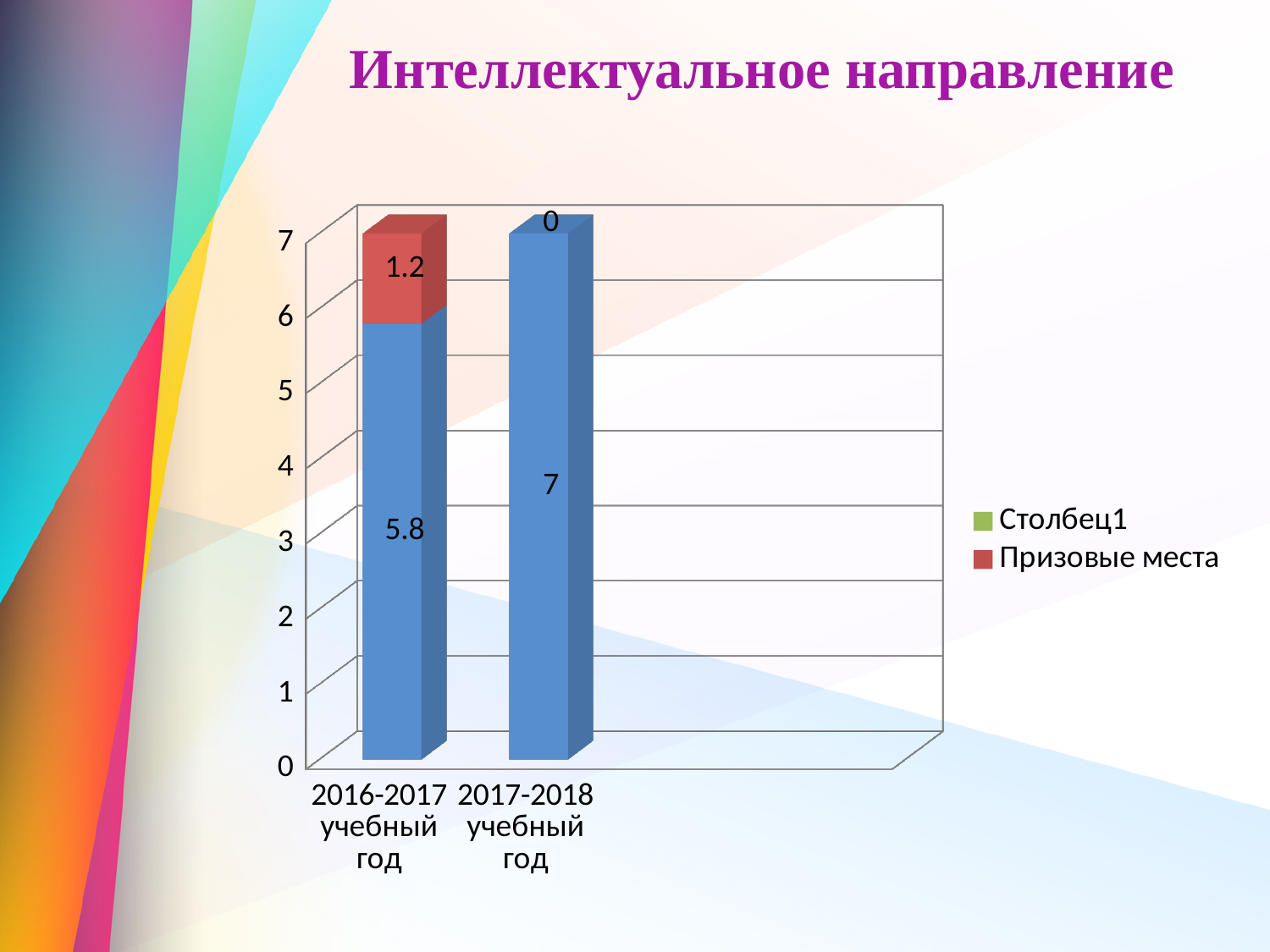
What value is shown for Призовые места in 2017-2018 учебный год? 0 What value is printed on the blue segment of the bar for 2017-2018 учебный год? 7 What kind of chart is shown on the slide? Bar chart What is the difference between the blue segment values for 2017-2018 and 2016-2017? 1.2 What value is printed on the blue segment of the bar for 2016-2017 учебный год? 5.8 What value is shown for Призовые места in 2016-2017 учебный год? 1.2 How many categories (academic years) are shown on the x axis? 2 What is the total of the stacked bar for 2016-2017 учебный год? 7 What is the title of the slide? Интеллектуальное направление How many entries does the legend list? 2 Which year has the larger blue segment, 2016-2017 or 2017-2018? 2017-2018 учебный год Which year has the higher value for Призовые места? 2016-2017 учебный год